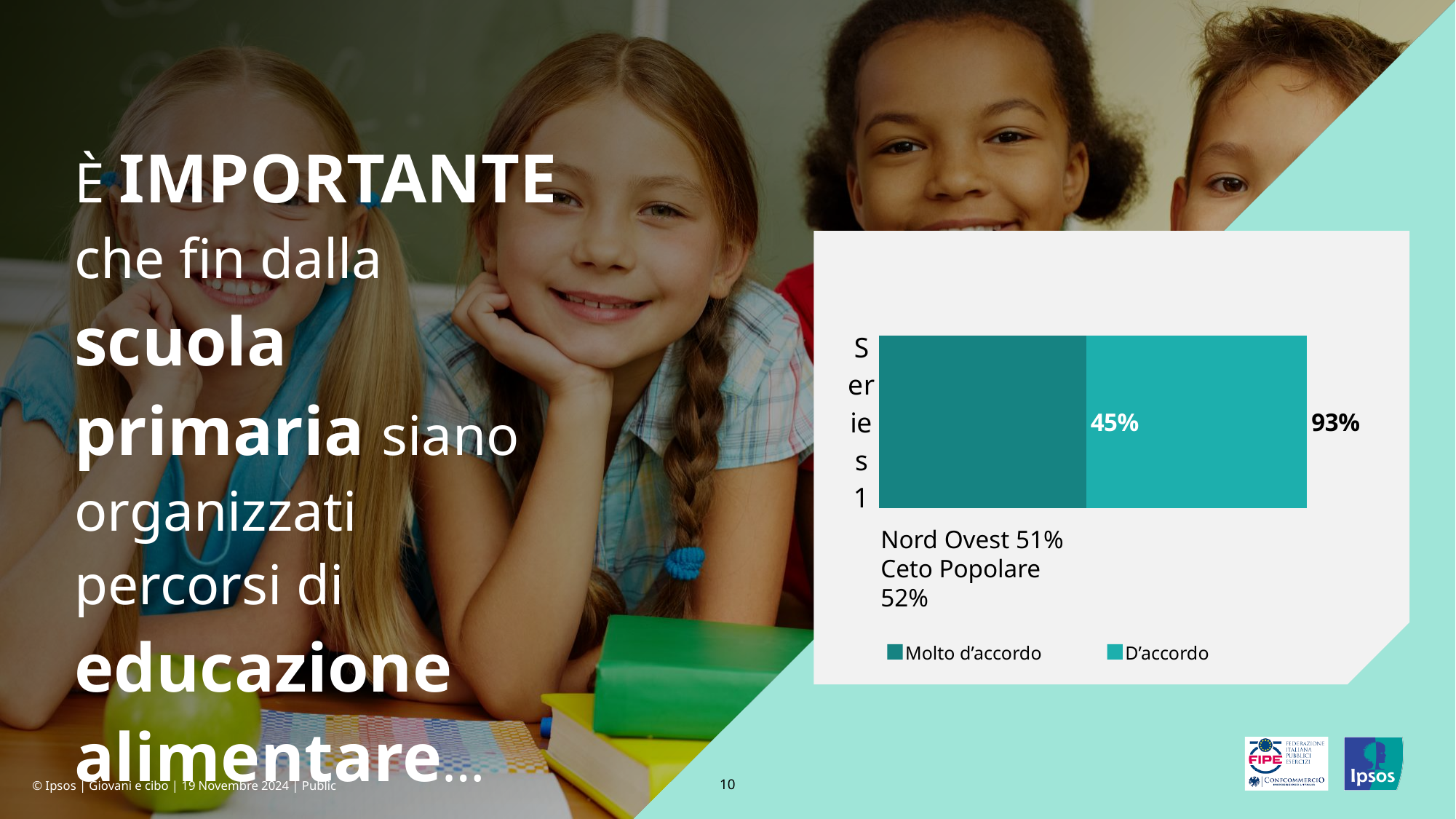
How many bars are plotted in the chart? 1 What are the two series named in the chart legend? Molto d'accordo and D'accordo What percentage is shown for Nord Ovest in the note below the bar? 51% What type of chart is shown on the slide? bar chart Is the value for 'Molto d'accordo' greater or less than 50%? less What is the total value printed at the end of the stacked bar? 93% What value is printed for the 'Molto d'accordo' segment of the bar? 45% Is the total value of the stacked bar greater or less than 90%? greater What percentage is shown for Ceto Popolare in the note below the bar? 52% How many series does the chart legend list? 2 What is the category label shown on the vertical axis of the chart? Series 1